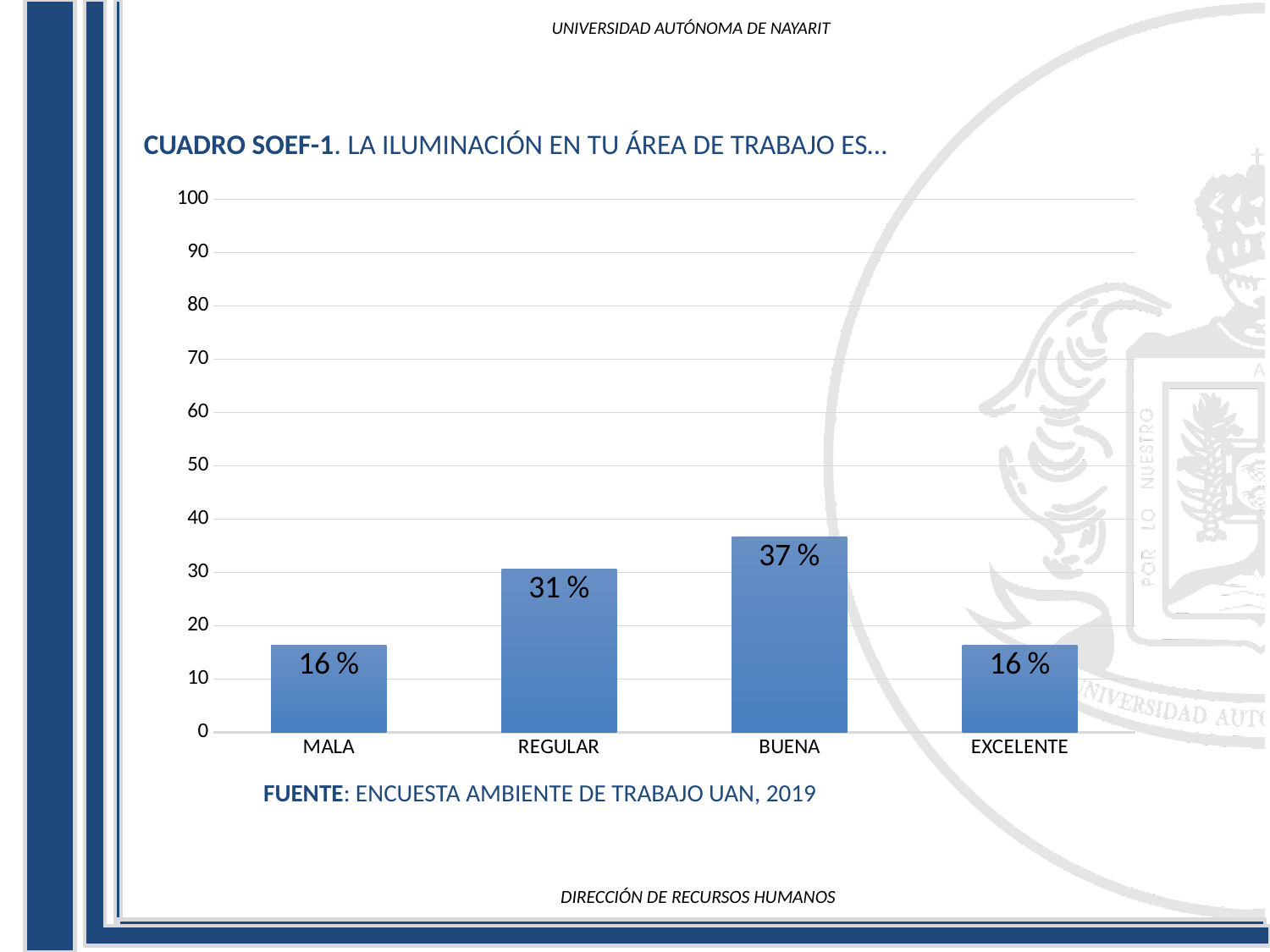
What is the difference between the values for REGULAR and MALA? 15 % What is the difference between the values for BUENA and REGULAR? 6 % Which is larger, the value for REGULAR or the value for EXCELENTE? REGULAR What is the value for EXCELENTE? 16 % What source is cited below the chart? ENCUESTA AMBIENTE DE TRABAJO UAN, 2019 Is the value for BUENA greater or less than 40? less What kind of chart is shown on the slide? bar chart What is the value for MALA? 16 % What is the value for BUENA? 37 % What is the value for REGULAR? 31 % Which category has the highest value? BUENA How many categories are shown on the x axis? 4